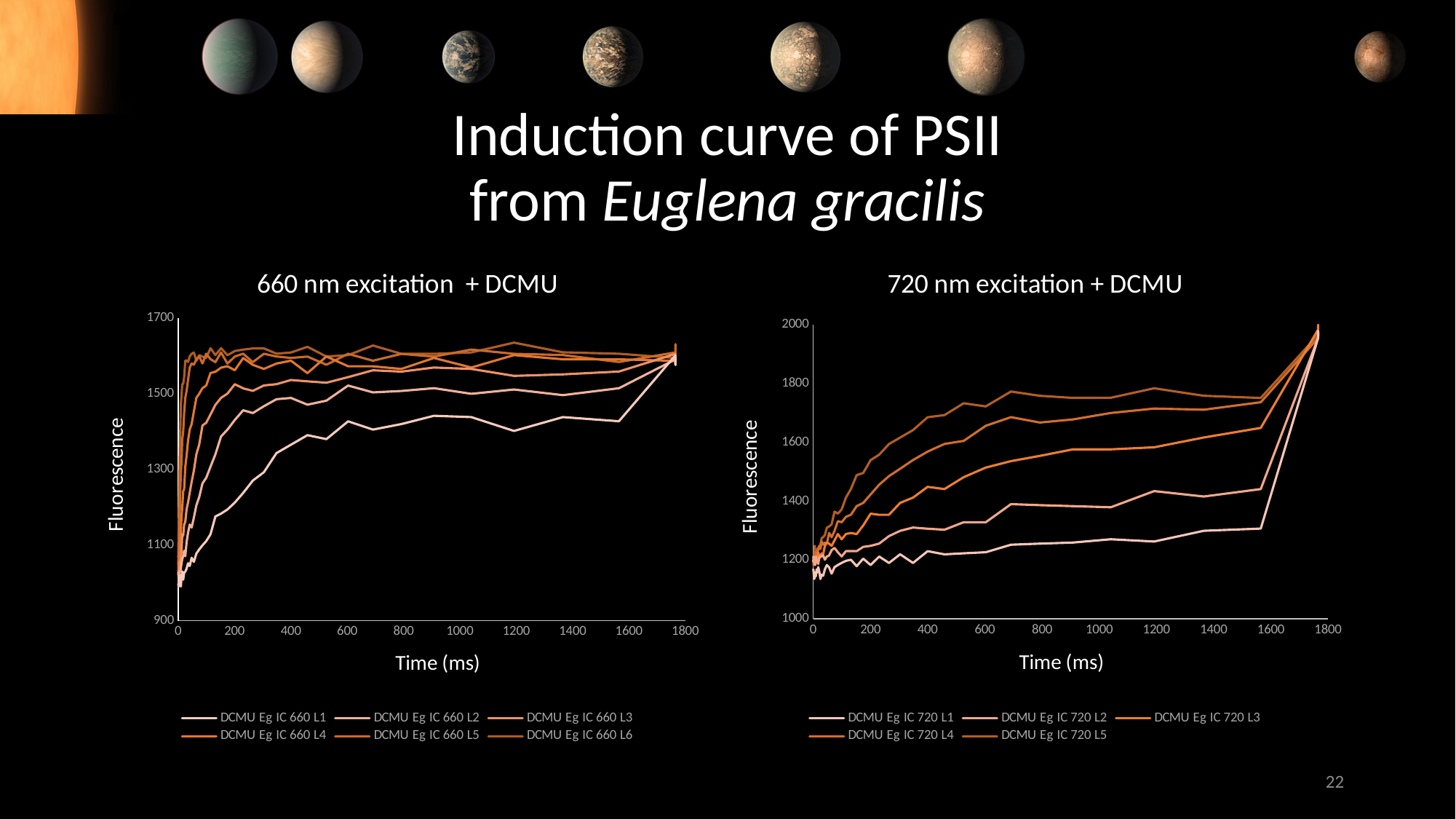
What is the y-axis title of the '720 nm excitation + DCMU' chart? Fluorescence How many series does the legend of the '660 nm excitation + DCMU' chart list? 6 In the '660 nm excitation + DCMU' chart, do the fluorescence values rise or fall over the first 200 ms? rise In the '660 nm excitation + DCMU' chart, are the fluorescence values of all series at the final time point (about 1800 ms) greater or less than 1500? greater How many series does the legend of the '720 nm excitation + DCMU' chart list? 5 In the '720 nm excitation + DCMU' chart, do the fluorescence values overall rise or fall from 0 ms to 1800 ms? rise In the '720 nm excitation + DCMU' chart, are the fluorescence values of all series at the final time point (about 1800 ms) greater or less than 1800? greater What is the x-axis title of the '660 nm excitation + DCMU' chart? Time (ms) What kind of chart is the '660 nm excitation + DCMU' chart? line chart In the '720 nm excitation + DCMU' chart, are the fluorescence values of all series at time 0 greater or less than 1400? less What kind of chart is the '720 nm excitation + DCMU' chart? line chart